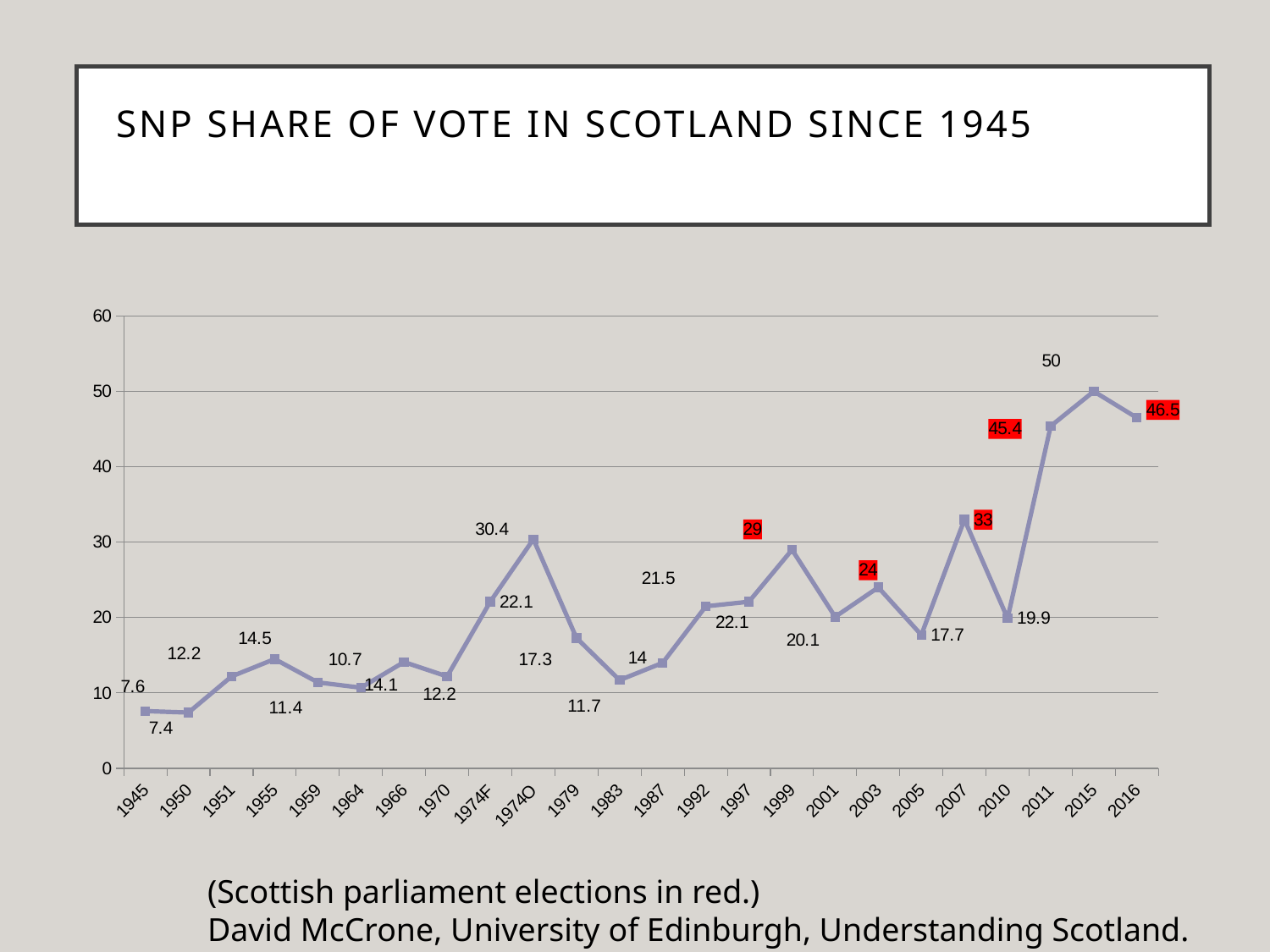
What is the SNP share of vote shown for 2015? 50 What kind of chart is shown on the slide? line chart What is the SNP share of vote shown for 2011? 45.4 According to the slide, what do the red data labels indicate? Scottish parliament elections Which year has the lowest SNP share of vote on the chart? 1950 What is the SNP share of vote shown for 1974O? 30.4 What is the difference between the SNP share of vote in 2015 and in 2016? 3.5 Is the SNP share of vote for 2010 greater or less than 20? less Which is larger, the SNP share of vote in 1999 or in 2003? 1999 Which year has the highest SNP share of vote on the chart? 2015 What is the SNP share of vote shown for 2007? 33 How many election points are plotted on the chart? 24